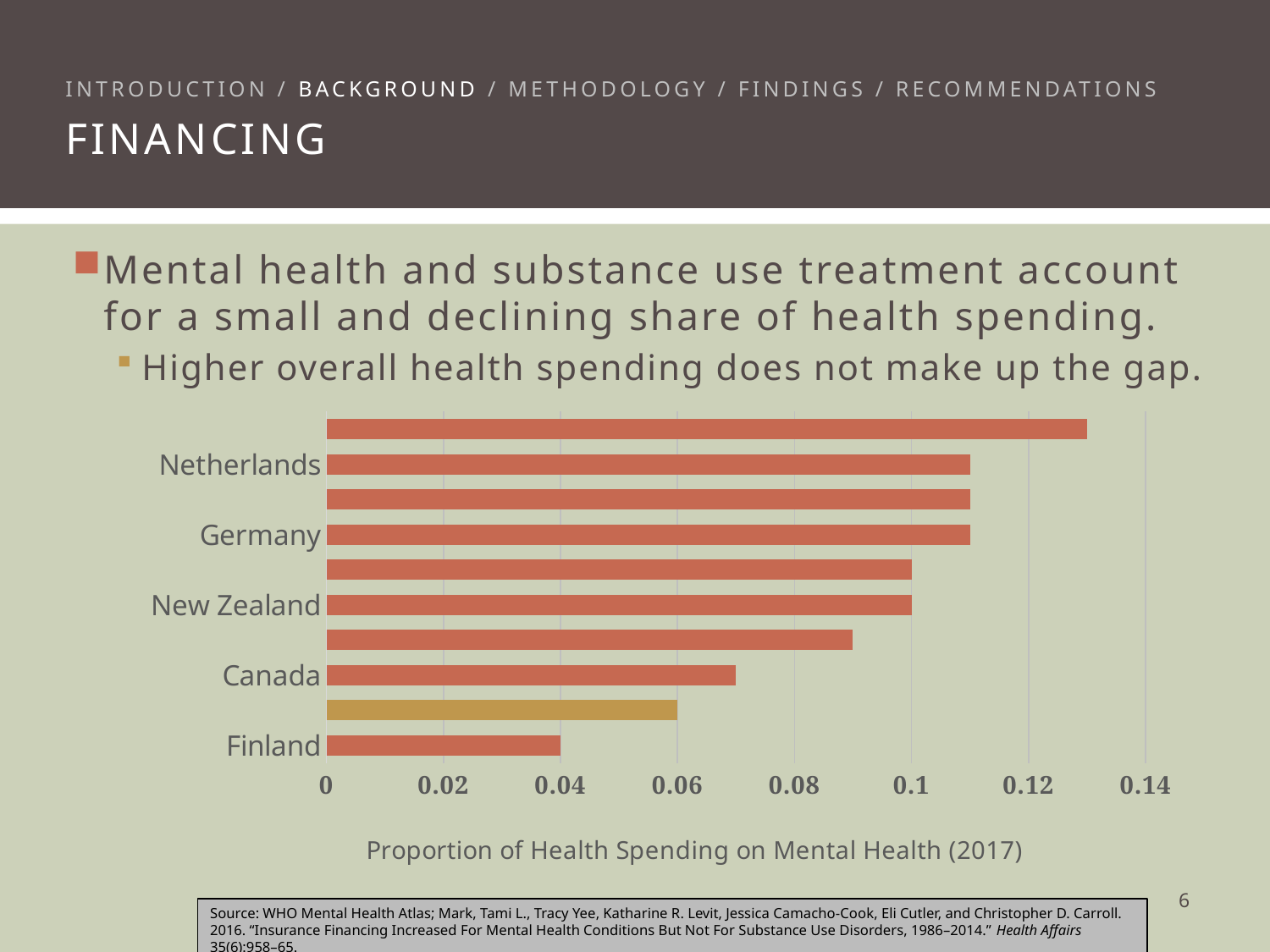
Which labelled country has the lowest value? Finland What is the value for New Zealand? 0.1 What is the value for Finland? 0.04 Which has the larger value, Netherlands or Canada? Netherlands Is the value for Germany greater or less than 0.1? greater What kind of chart is shown on the slide? bar chart Is the value for Netherlands greater or less than 0.1? greater Is the value for Canada greater or less than 0.08? less What is the difference between the values for New Zealand and Finland? 0.06 How many bars are plotted in the chart? 10 Which has the larger value, Germany or Finland? Germany What is the title shown beneath the chart? Proportion of Health Spending on Mental Health (2017)